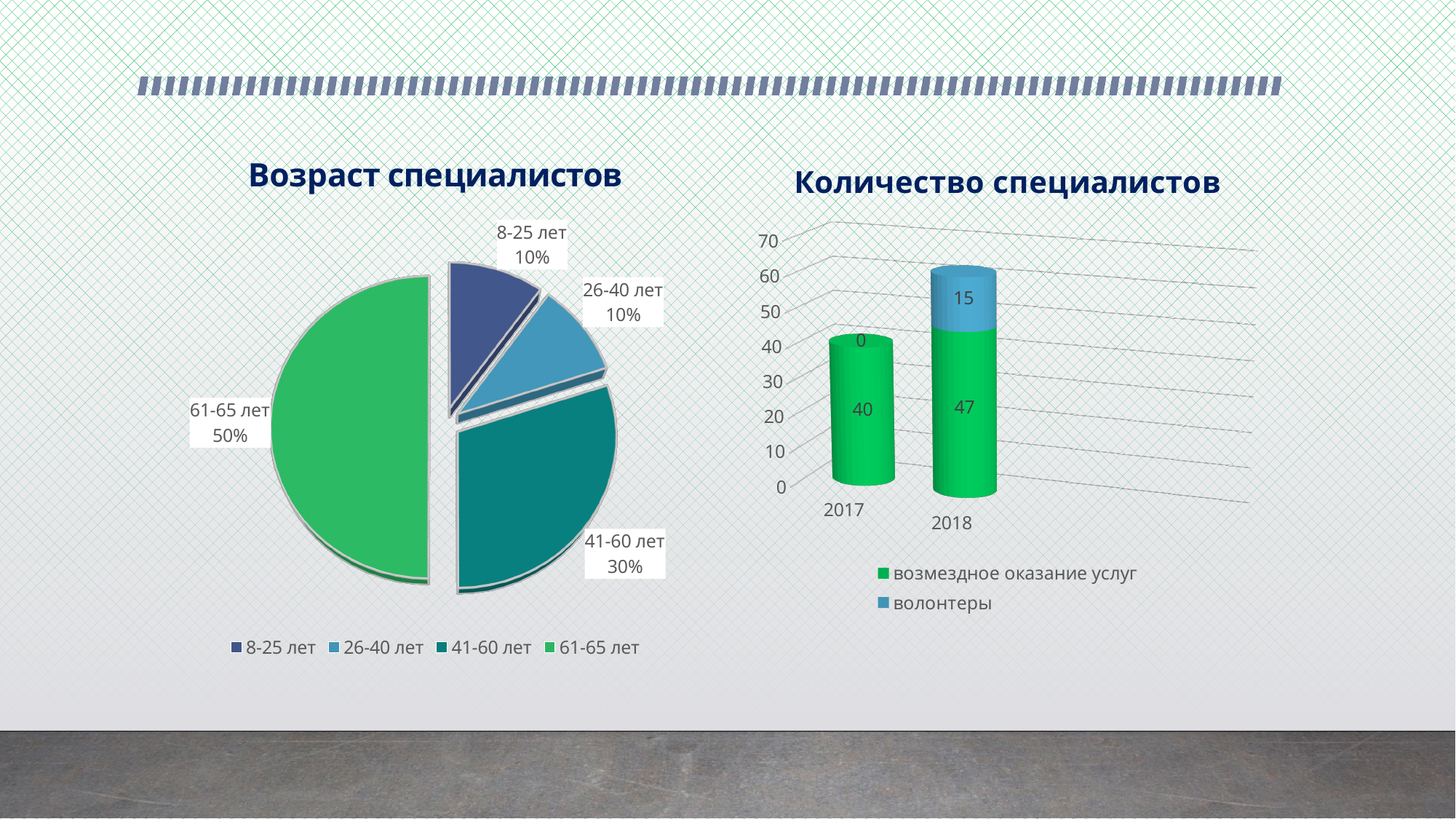
In the chart titled "Количество специалистов", how many series does the legend list? 2 In the chart titled "Возраст специалистов", how many slices does the pie have? 4 In the chart titled "Количество специалистов", what is the value for "волонтеры" in 2018? 15 In the chart titled "Возраст специалистов", which age group has the largest share? 61-65 лет In the chart titled "Количество специалистов", what is the difference between the "возмездное оказание услуг" values for 2018 and 2017? 7 In the chart titled "Количество специалистов", what is the total of the stacked bar for 2018? 62 In the chart titled "Количество специалистов", what is the value for "возмездное оказание услуг" in 2018? 47 What kind of chart is "Количество специалистов"? bar chart In the chart titled "Возраст специалистов", what share does the "61-65 лет" slice have? 50% In the chart titled "Количество специалистов", what is the value for "волонтеры" in 2017? 0 What kind of chart is "Возраст специалистов"? pie chart In the chart titled "Возраст специалистов", what share does the "41-60 лет" slice have? 30%